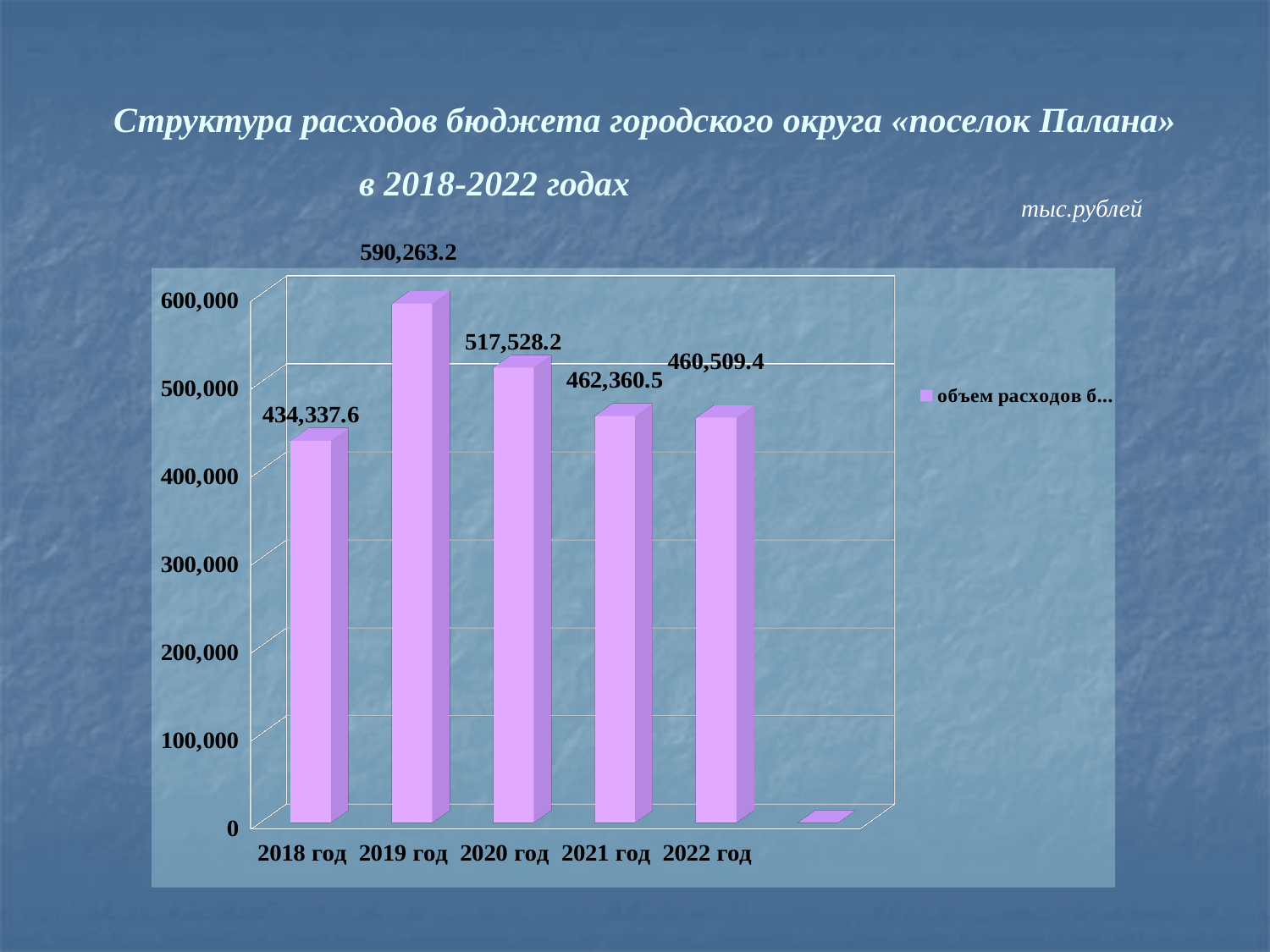
Which is larger, the value for 2019 год or 2020 год? 2019 год What is the value for 2018 год? 434,337.6 Which year has the lowest value? 2018 год Which year has the highest value? 2019 год What is the difference between the values for 2019 год and 2018 год? 155,925.6 Is the value for 2018 год greater or less than 400,000? greater What is the value for 2020 год? 517,528.2 Do the values rise or fall from 2019 год to 2022 год? fall How many years are labeled on the x axis? 5 What is the value for 2022 год? 460,509.4 What is the difference between the values for 2020 год and 2021 год? 55,167.7 What kind of chart is shown on the slide? bar chart